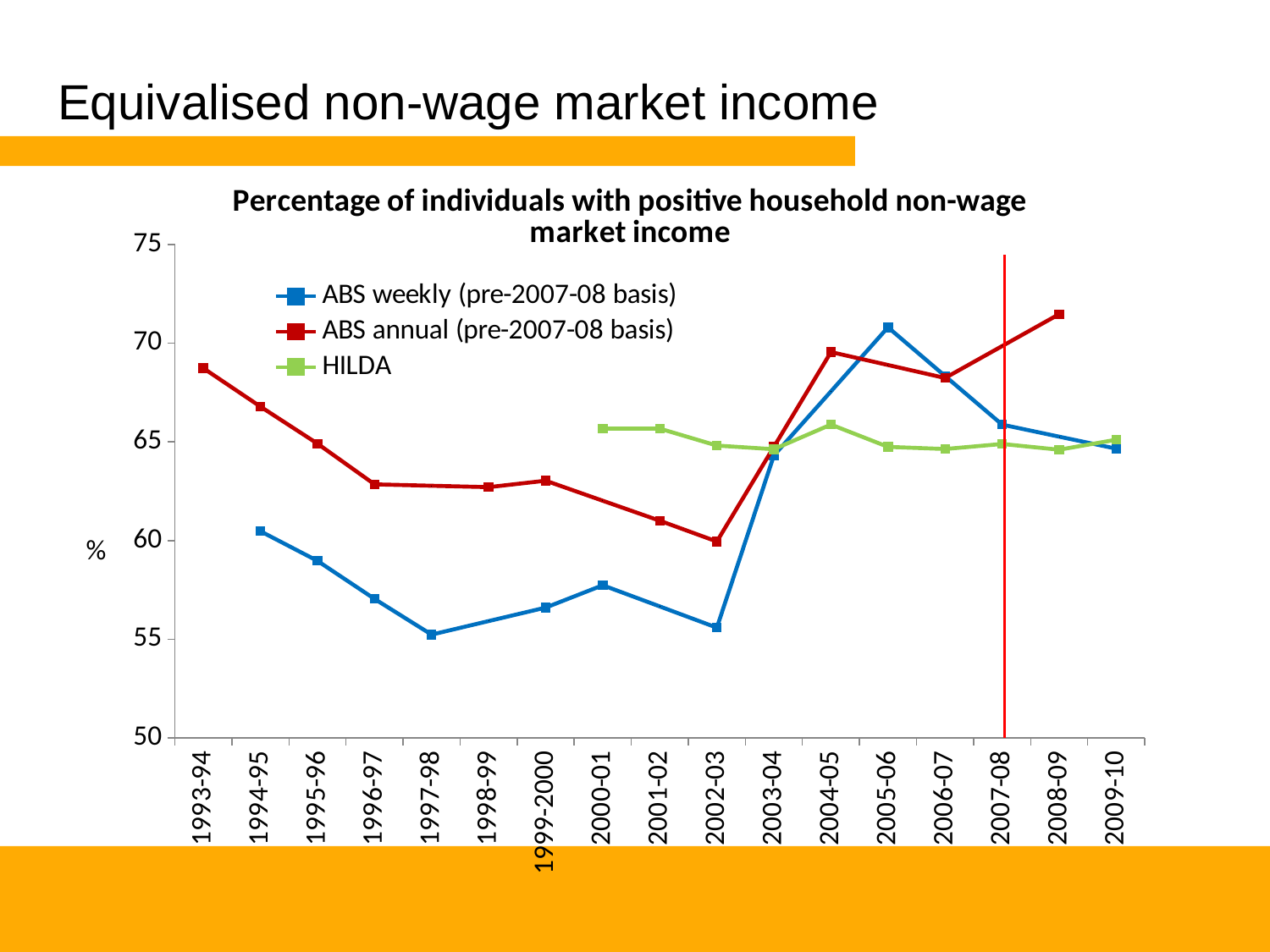
Is the value for ABS annual (pre-2007-08 basis) in 1993-94 greater or less than 65? greater How many year categories are shown on the x axis? 17 In which year is the ABS weekly (pre-2007-08 basis) series at its lowest? 1997-98 Does the ABS annual (pre-2007-08 basis) series rise or fall from 1993-94 to 1996-97? fall How many series does the legend list? 3 In which year is the ABS weekly (pre-2007-08 basis) series at its highest? 2005-06 In which year is the ABS annual (pre-2007-08 basis) series at its highest? 2008-09 Is the value for ABS weekly (pre-2007-08 basis) in 1997-98 greater or less than 60? less What is the title of the chart? Percentage of individuals with positive household non-wage market income What kind of chart is shown on the slide? line chart Is the value for HILDA in 2009-10 greater or less than 70? less In 1994-95, which series has the larger value: ABS weekly (pre-2007-08 basis) or ABS annual (pre-2007-08 basis)? ABS annual (pre-2007-08 basis)